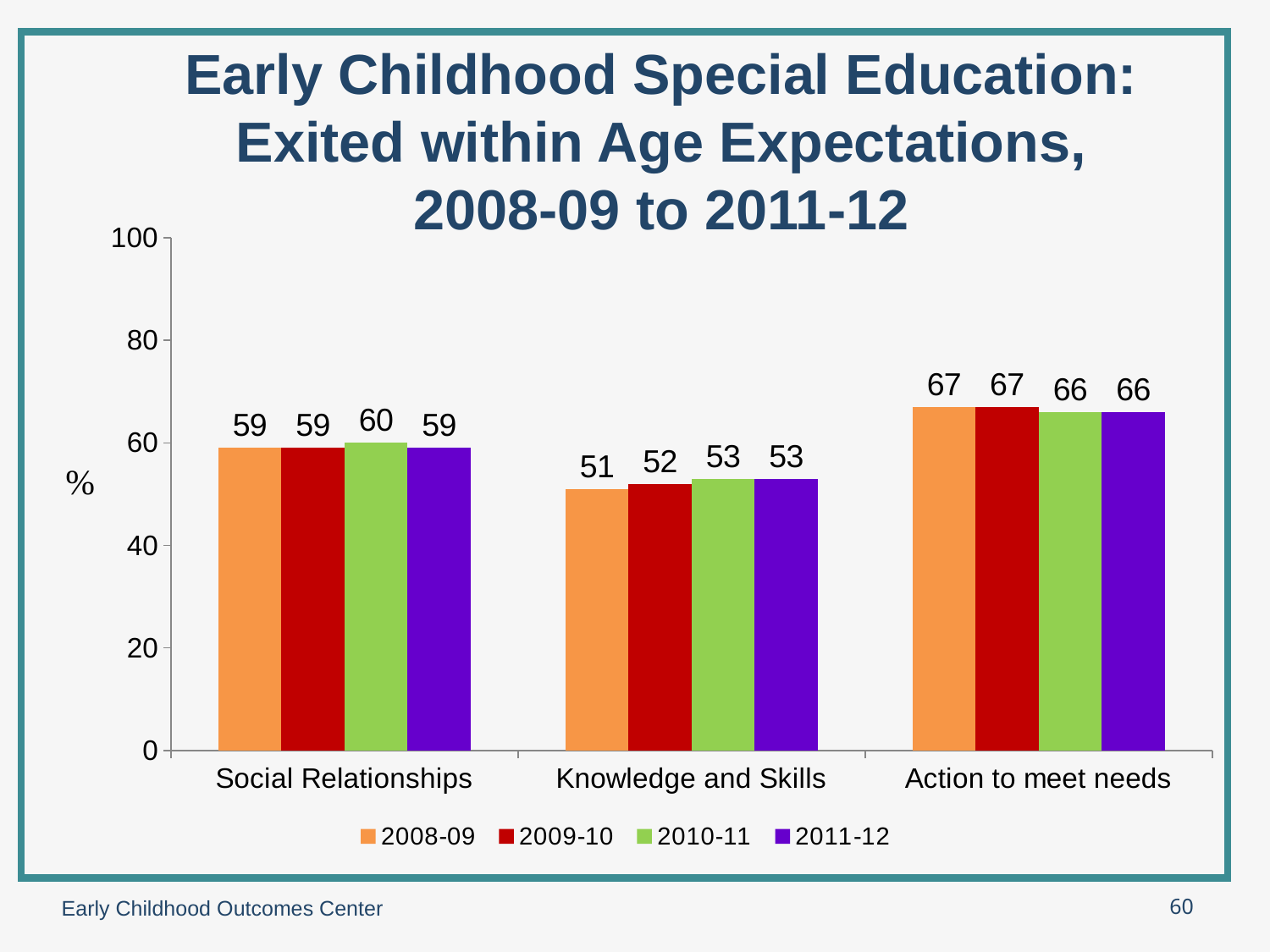
What is the value for Action to meet needs in 2011-12? 66 Which series is shown in purple in the legend? 2011-12 How many series does the legend list? 4 What is the value for Social Relationships in 2010-11? 60 Which is larger: the 2010-11 value for Social Relationships or the 2010-11 value for Knowledge and Skills? Social Relationships What is the value for Knowledge and Skills in 2008-09? 51 What kind of chart is shown on the slide? bar chart Which category has the highest value in 2009-10? Action to meet needs How many categories are shown on the x axis? 3 What is the difference between the 2008-09 values for Action to meet needs and Knowledge and Skills? 16 Is the value for Knowledge and Skills in 2011-12 greater or less than 60? less Which category has the lowest value in 2011-12? Knowledge and Skills